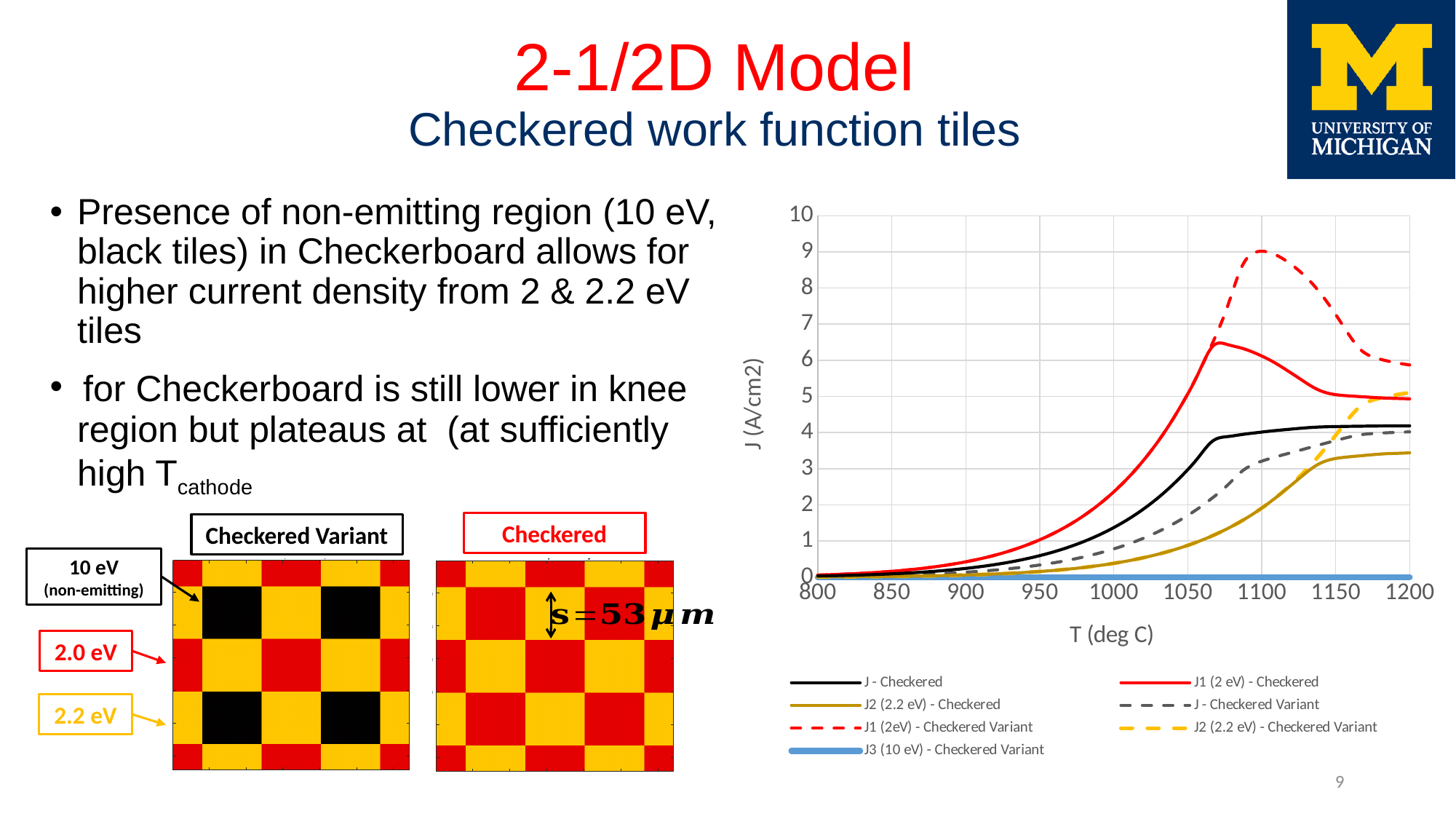
What is the label of the chart's x axis? T (deg C) What is the label of the chart's y axis? J (A/cm2) What kind of chart is shown on the right of the slide? line chart Is the value of J2 (2.2 eV) - Checkered at 1200 deg C greater or less than 3? greater Is the value of J3 (10 eV) - Checkered Variant at 1200 deg C greater or less than 1? less Is the peak value of J1 (2eV) - Checkered Variant near 1100 deg C greater or less than 8? greater Which series reaches the highest value on the chart? J1 (2eV) - Checkered Variant Which series stays lowest across the whole temperature range? J3 (10 eV) - Checkered Variant At 1000 deg C, which is larger: J1 (2 eV) - Checkered or J2 (2.2 eV) - Checkered? J1 (2 eV) - Checkered Does J - Checkered rise or fall as temperature increases from 800 to 1200 deg C? rise How many series does the chart legend list? 7